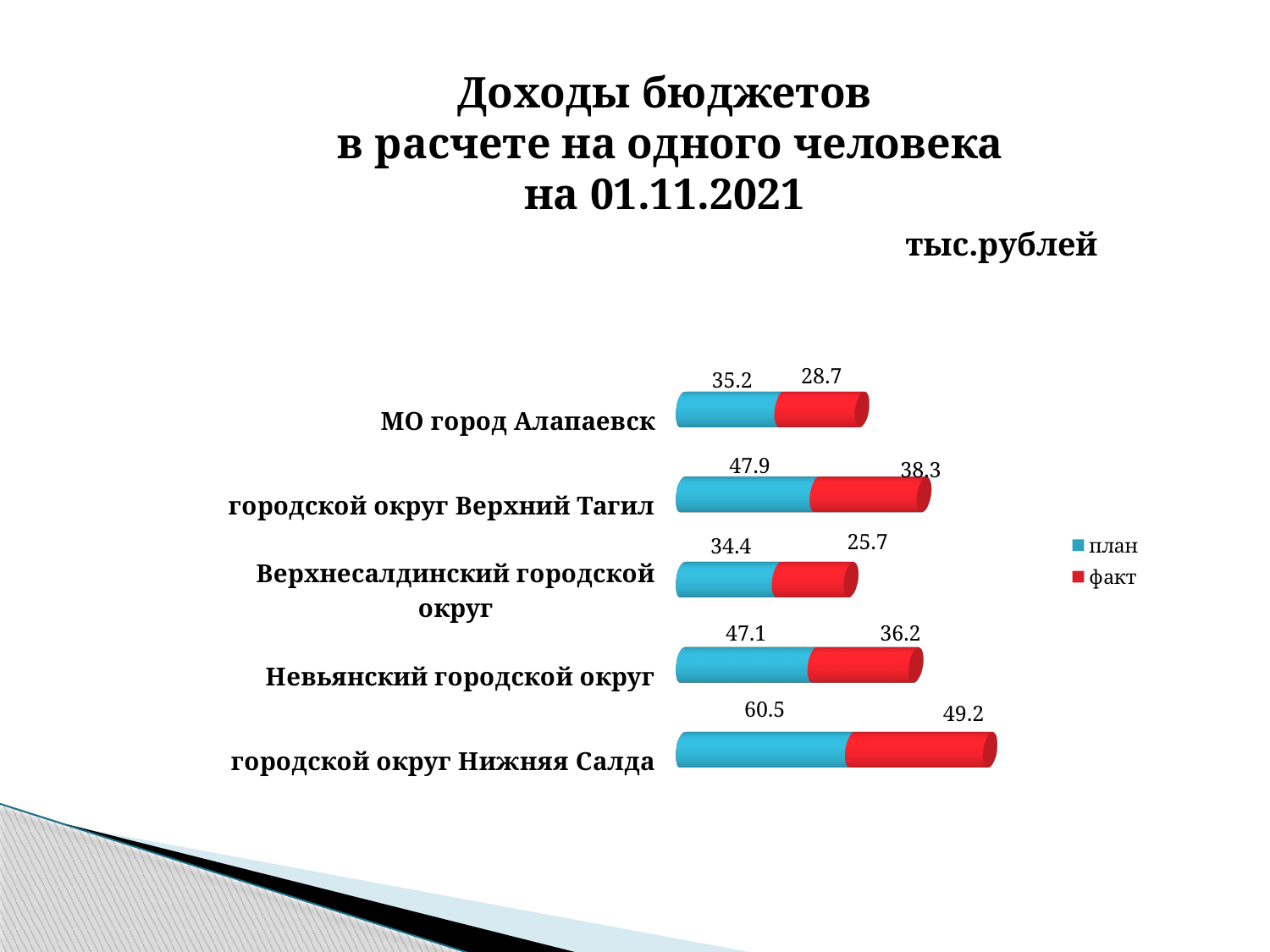
How many categories are shown in the chart? 5 What is the total of the stacked bar for МО город Алапаевск? 63.9 What is the difference between the план and факт values for городской округ Верхний Тагил? 9.6 How many series does the legend list? 2 Which category has the lowest план value? Верхнесалдинский городской округ What is the план value for городской округ Нижняя Салда? 60.5 What is the план value for Невьянский городской округ? 47.1 Which category has the highest факт value? городской округ Нижняя Салда What kind of chart is shown on the slide? bar chart What is the факт value for Верхнесалдинский городской округ? 25.7 What is the факт value for МО город Алапаевск? 28.7 Which is larger, the факт value for Невьянский городской округ or the факт value for городской округ Верхний Тагил? городской округ Верхний Тагил